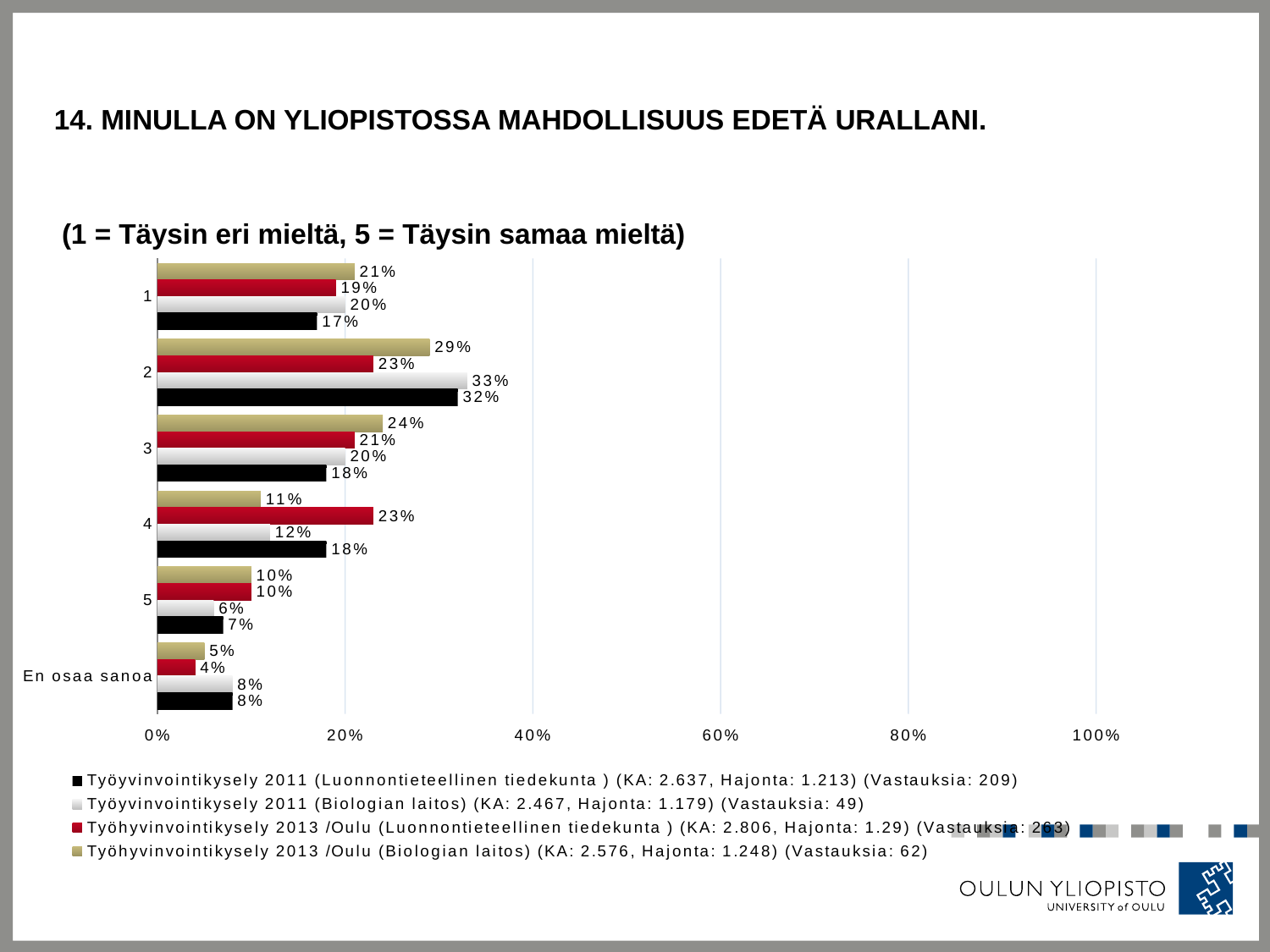
What is the value for 'En osaa sanoa' in the Työhyvinvointikysely 2013 /Oulu (Biologian laitos) series? 5% How many categories are shown on the vertical axis? 6 Which category has the highest value in the Työyvinvointikysely 2011 (Luonnontieteellinen tiedekunta) series? 2 Which category has the lowest value in the Työhyvinvointikysely 2013 /Oulu (Luonnontieteellinen tiedekunta) series? En osaa sanoa Is the value for category 2 in the Työyvinvointikysely 2011 (Luonnontieteellinen tiedekunta) series greater or less than 20%? greater What kind of chart is shown on the slide? bar chart What is the value for category 4 in the Työhyvinvointikysely 2013 /Oulu (Luonnontieteellinen tiedekunta) series? 23% What is the value for category 2 in the Työyvinvointikysely 2011 (Biologian laitos) series? 33% How many responses (Vastauksia) does the legend give for the Työhyvinvointikysely 2013 /Oulu (Luonnontieteellinen tiedekunta) series? 263 What is the difference between the Työhyvinvointikysely 2013 /Oulu (Biologian laitos) value and the Työyvinvointikysely 2011 (Biologian laitos) value for category 4? 1% For category 3, which series has the larger value: Työhyvinvointikysely 2013 /Oulu (Biologian laitos) or Työyvinvointikysely 2011 (Luonnontieteellinen tiedekunta)? Työhyvinvointikysely 2013 /Oulu (Biologian laitos) How many series does the legend list? 4